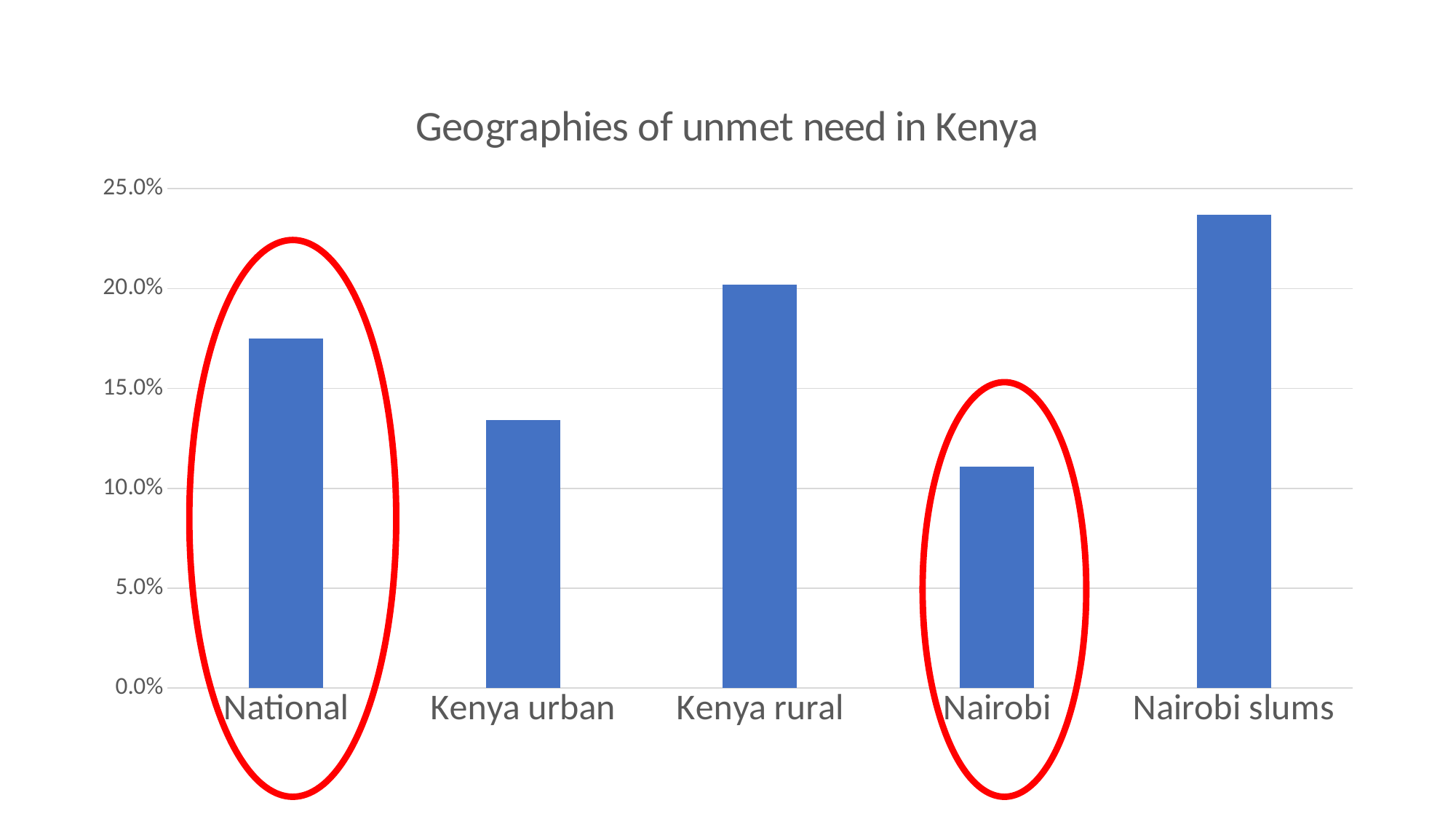
What kind of chart is shown on the slide? bar chart Which two categories are circled in red on the chart? National and Nairobi What is the title of the chart? Geographies of unmet need in Kenya How many categories are plotted on the chart? 5 Is the value for Kenya urban greater or less than 15.0%? less Is the value for Nairobi greater or less than 10.0%? greater Which category has the highest value? Nairobi slums Is the value for National greater or less than 15.0%? greater Which is larger, the value for National or the value for Nairobi? National Which is larger, the value for Kenya rural or the value for Kenya urban? Kenya rural Which category has the lowest value? Nairobi